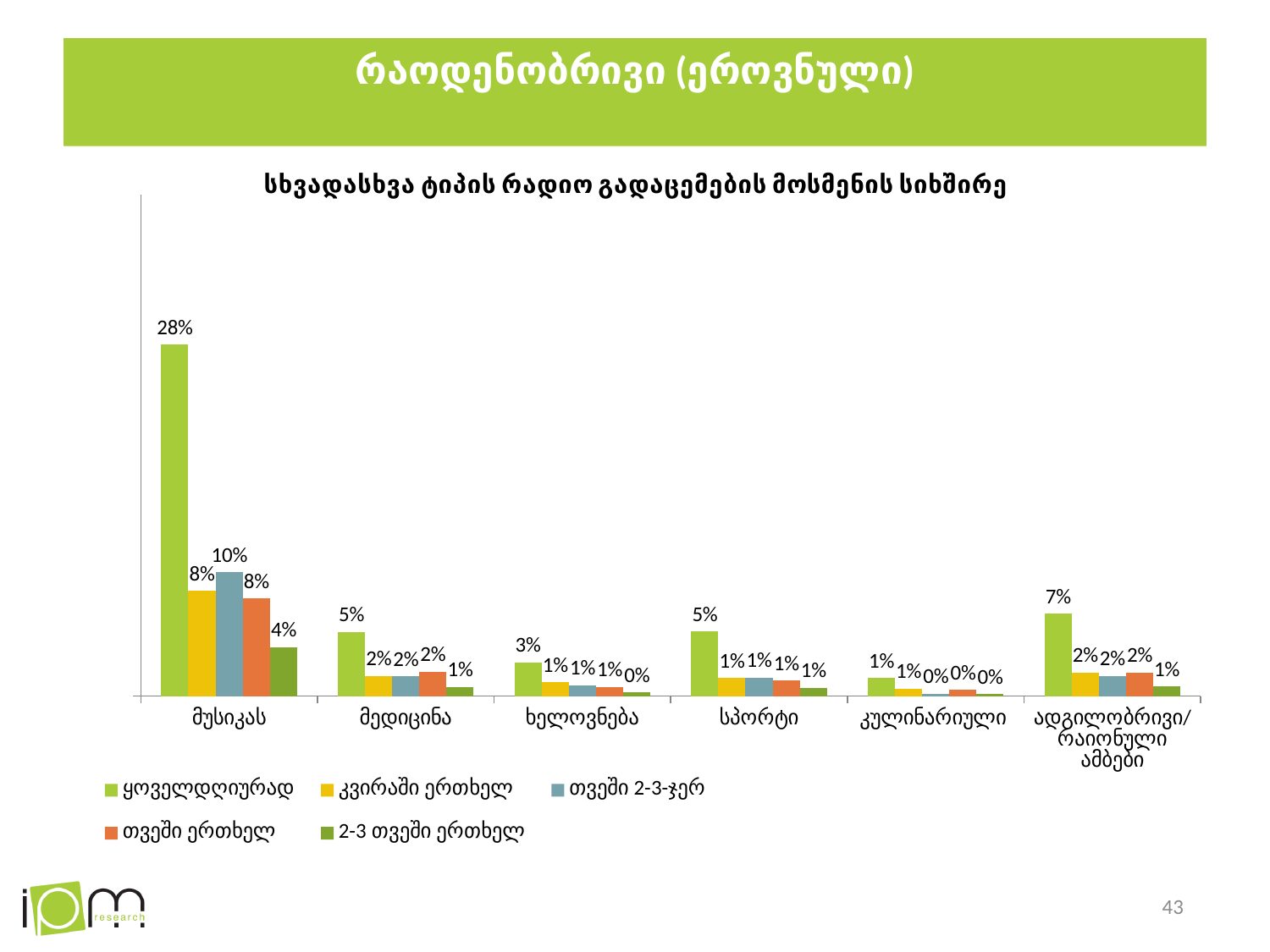
What is the value for ყოველდღიურად in the ადგილობრივი/რაიონული ამბები category? 7% Which is larger: the ყოველდღიურად value for სპორტი or for ხელოვნება? სპორტი Which category has the lowest value for ყოველდღიურად? კულინარიული What is the difference between the ყოველდღიურად values for მუსიკას and მედიცინა? 23% What kind of chart is shown on the slide? Bar chart What is the value for 2-3 თვეში ერთხელ in the ხელოვნება category? 0% What is the value for ყოველდღიურად in the მუსიკას category? 28% What is the value for თვეში 2-3-ჯერ in the მუსიკას category? 10% How many series does the legend list? 5 What is the title of the chart? სხვადასხვა ტიპის რადიო გადაცემების მოსმენის სიხშირე How many categories are shown on the x axis? 6 Which category has the highest value for ყოველდღიურად? მუსიკას